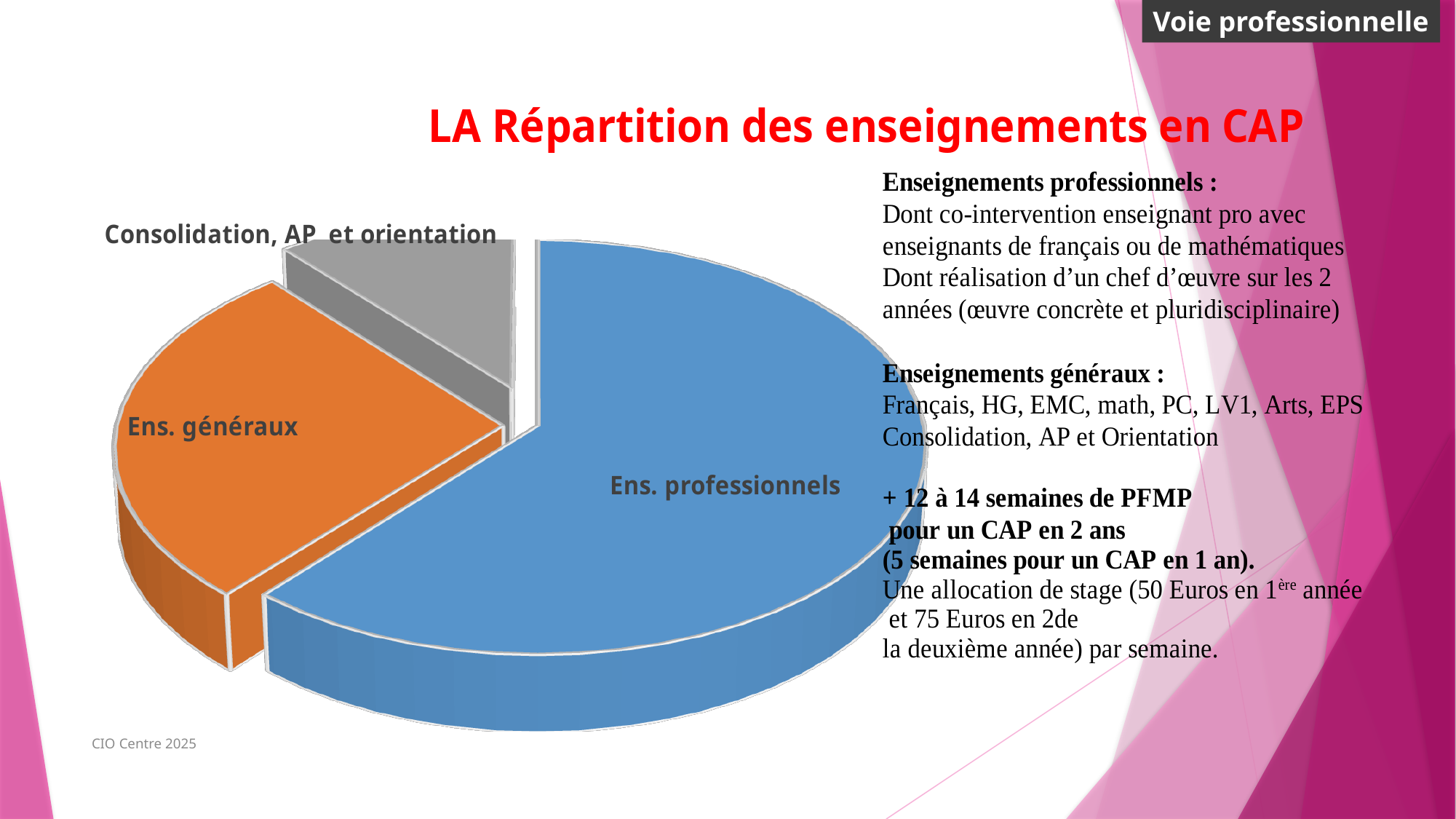
How many slices does the pie chart have? 3 Which category has the smallest slice of the pie chart? Consolidation, AP et orientation Which slice is larger: Ens. généraux or Ens. professionnels? Ens. professionnels Which slice is larger: Ens. généraux or Consolidation, AP et orientation? Ens. généraux Which slice is smaller: Ens. professionnels or Consolidation, AP et orientation? Consolidation, AP et orientation Which category has the largest slice of the pie chart? Ens. professionnels What kind of chart is shown on the slide? pie chart Which category is shown in orange on the pie chart? Ens. généraux What colour is the Ens. professionnels slice of the pie chart? blue